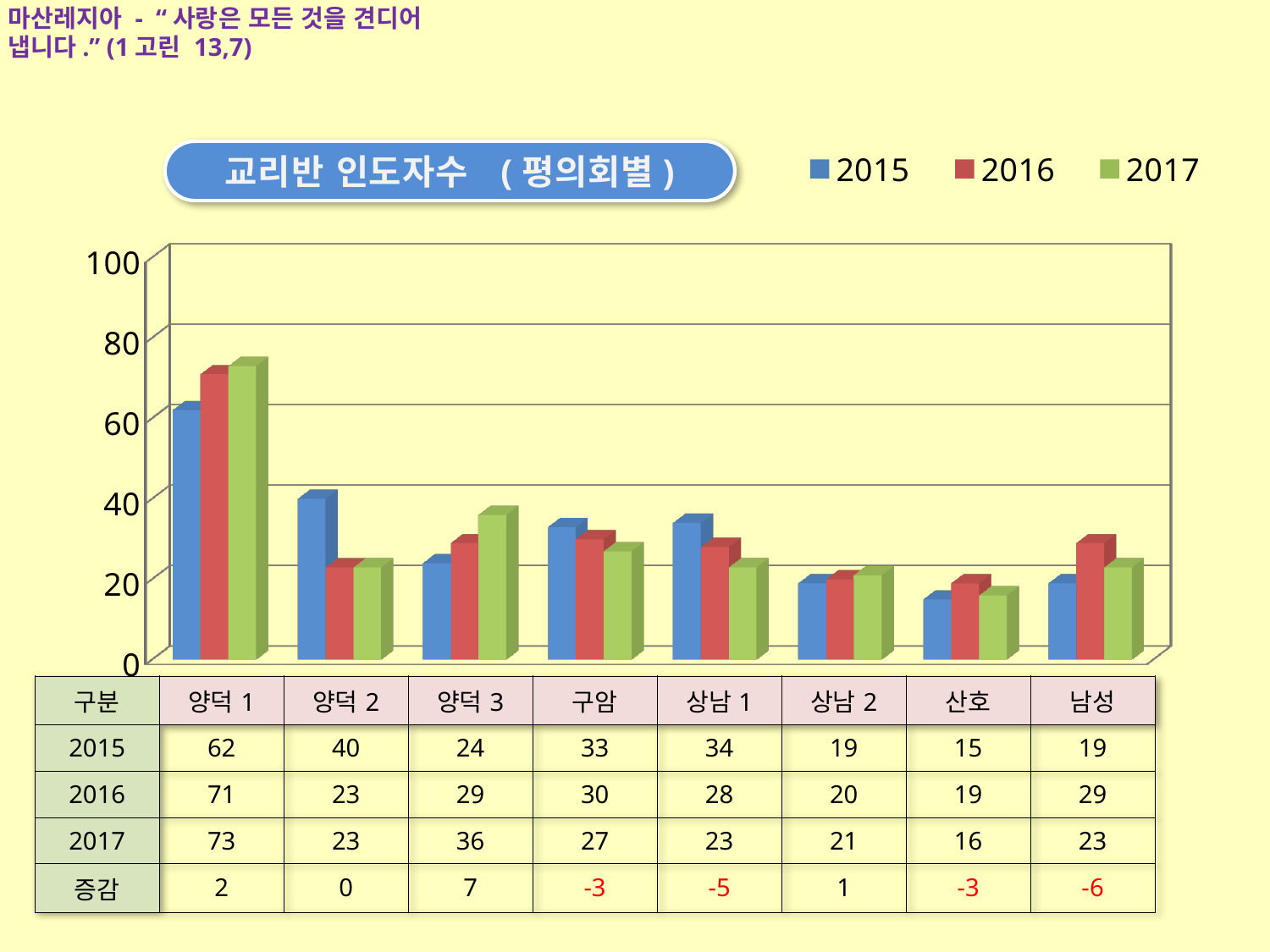
Which category has the lowest value in the 2017 series? 산호 Which is larger for 상남 1: the 2015 value or the 2017 value? 2015 What is the value for 남성 in the 2016 series? 29 What kind of chart is shown on the slide? bar chart What colour represents the 2016 series in the chart? red What is the value for 구암 in the 2015 series? 33 Is the 2016 value for 양덕 1 greater or less than 60? greater What is the difference between the 2017 and 2015 values for 양덕 3? 12 How many series does the legend list? 3 How many categories are shown on the x axis of the chart? 8 Which category has the highest value in the 2015 series? 양덕 1 What is the value for 양덕 1 in the 2017 series? 73